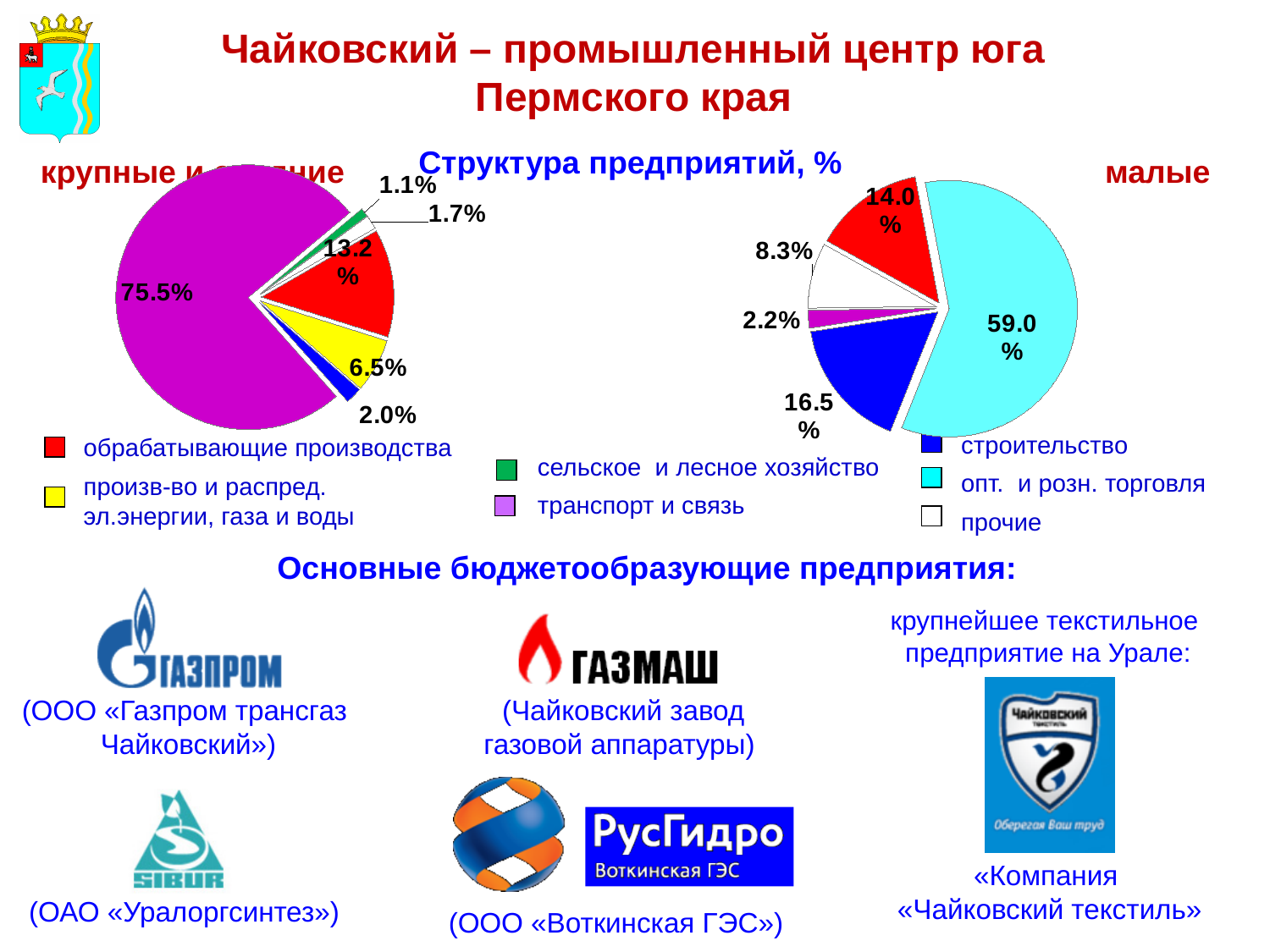
In the right pie chart (малые), what is the difference between the largest slice (59.0%) and the blue slice (16.5%)? 42.5% In the left pie chart (крупные и средние), what is the share of the largest slice? 75.5% In the left pie chart (крупные и средние), what is the share of the smallest slice? 1.1% In the right pie chart (малые), what is the share of the blue slice (строительство)? 16.5% In the right pie chart (малые), what is the share of the smallest slice? 2.2% How many slices does the right pie chart (малые) have? 5 In the right pie chart (малые), what is the share of the largest slice? 59.0% Which is larger: the red slice in the left pie chart (13.2%) or the red slice in the right pie chart (14.0%)? the right pie chart (14.0%) How many slices does the left pie chart (крупные и средние) have? 6 In the left pie chart (крупные и средние), what is the share of the yellow slice (произв-во и распред. эл.энергии, газа и воды)? 6.5% In the right pie chart (малые), what is the share of the red slice (обрабатывающие производства)? 14.0% What type of charts are shown on the slide under "Структура предприятий, %"? pie charts